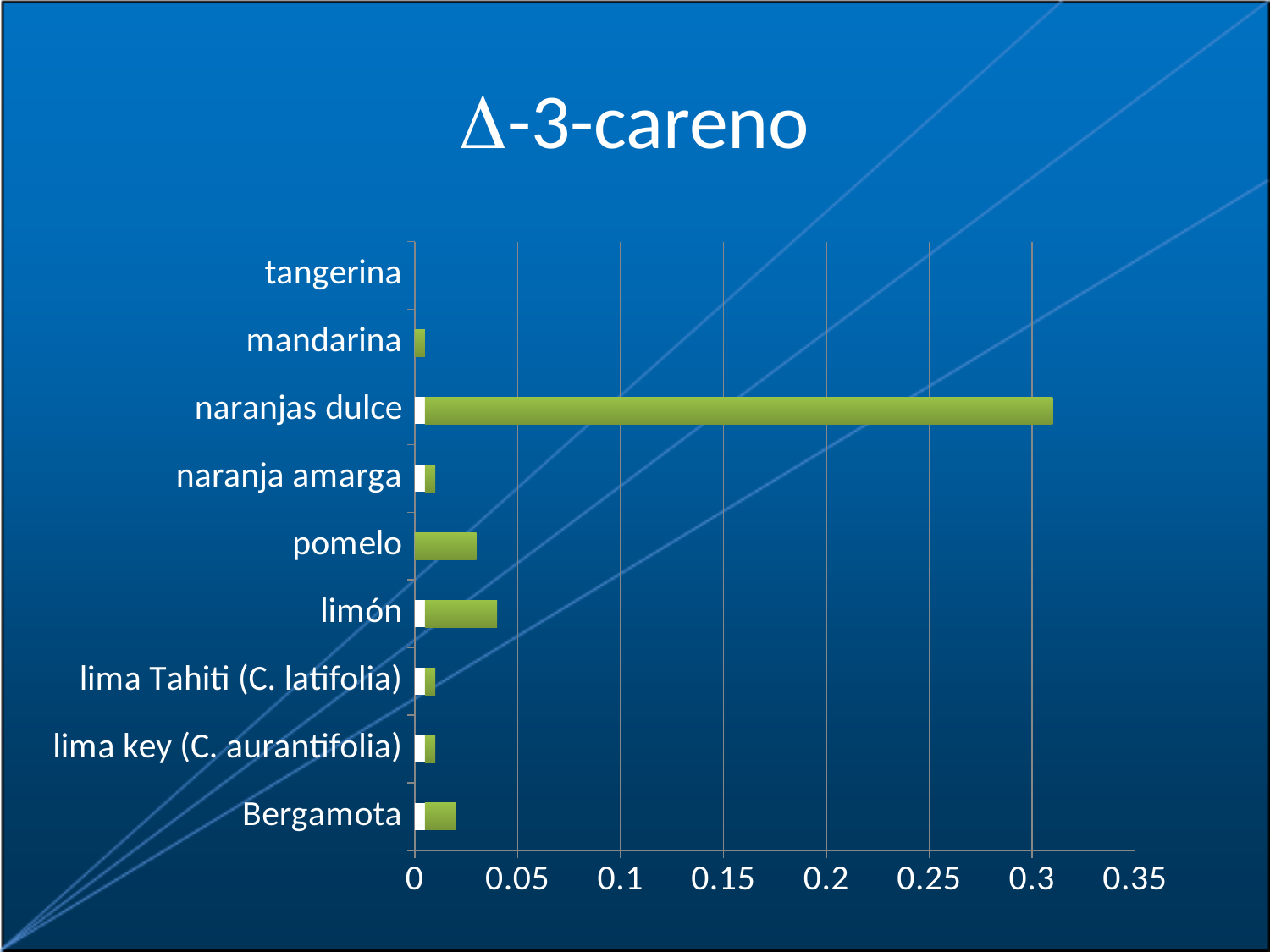
What is the highest value shown on the horizontal axis? 0.35 Which has a larger value, limón or pomelo? limón Which has a larger value, naranjas dulce or Bergamota? naranjas dulce How many categories are plotted on the chart? 9 Which category has the highest value? naranjas dulce Which has a larger value, Bergamota or mandarina? Bergamota Which category has the lowest value? tangerina Is the value for pomelo greater or less than 0.1? less Is the value for naranjas dulce greater or less than 0.25? greater What kind of chart is shown on the slide? bar chart Is the value for limón greater or less than 0.05? less What is the title of the chart? Δ-3-careno